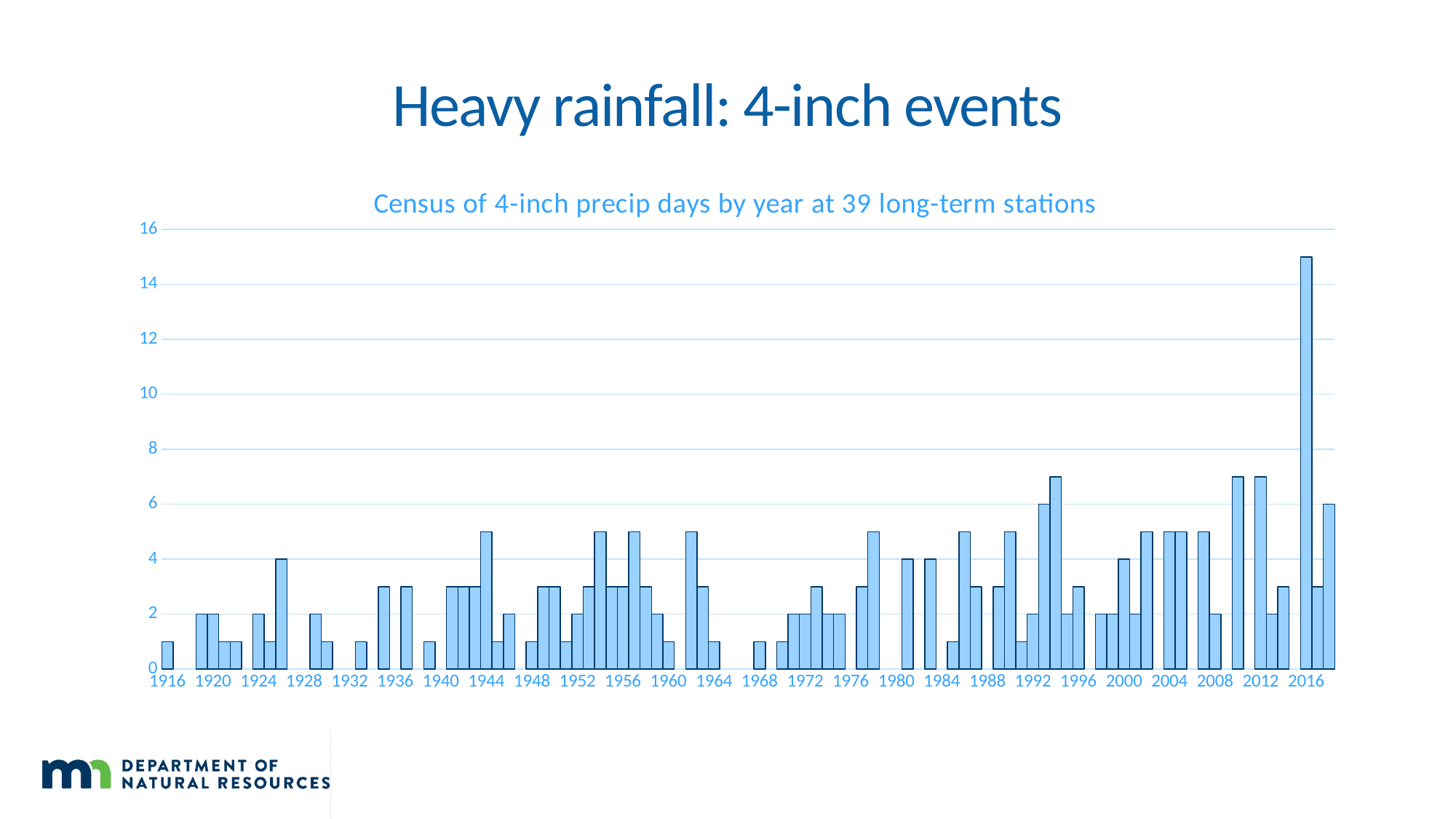
What is the value for 1920? 2 What is the highest value shown on the vertical axis? 16 What is the subtitle of the chart? Census of 4-inch precip days by year at 39 long-term stations What is the value for 1952? 2 What kind of chart is shown on the slide? bar chart Which year has the larger value, 2016 or 2012? 2016 Which year has the highest number of 4-inch precip days? 2016 Is the value for 1916 greater or less than 2? less Is the value for 1944 greater or less than 4? greater Is the value for 2016 greater or less than 14? greater Which year has the larger value, 1944 or 1916? 1944